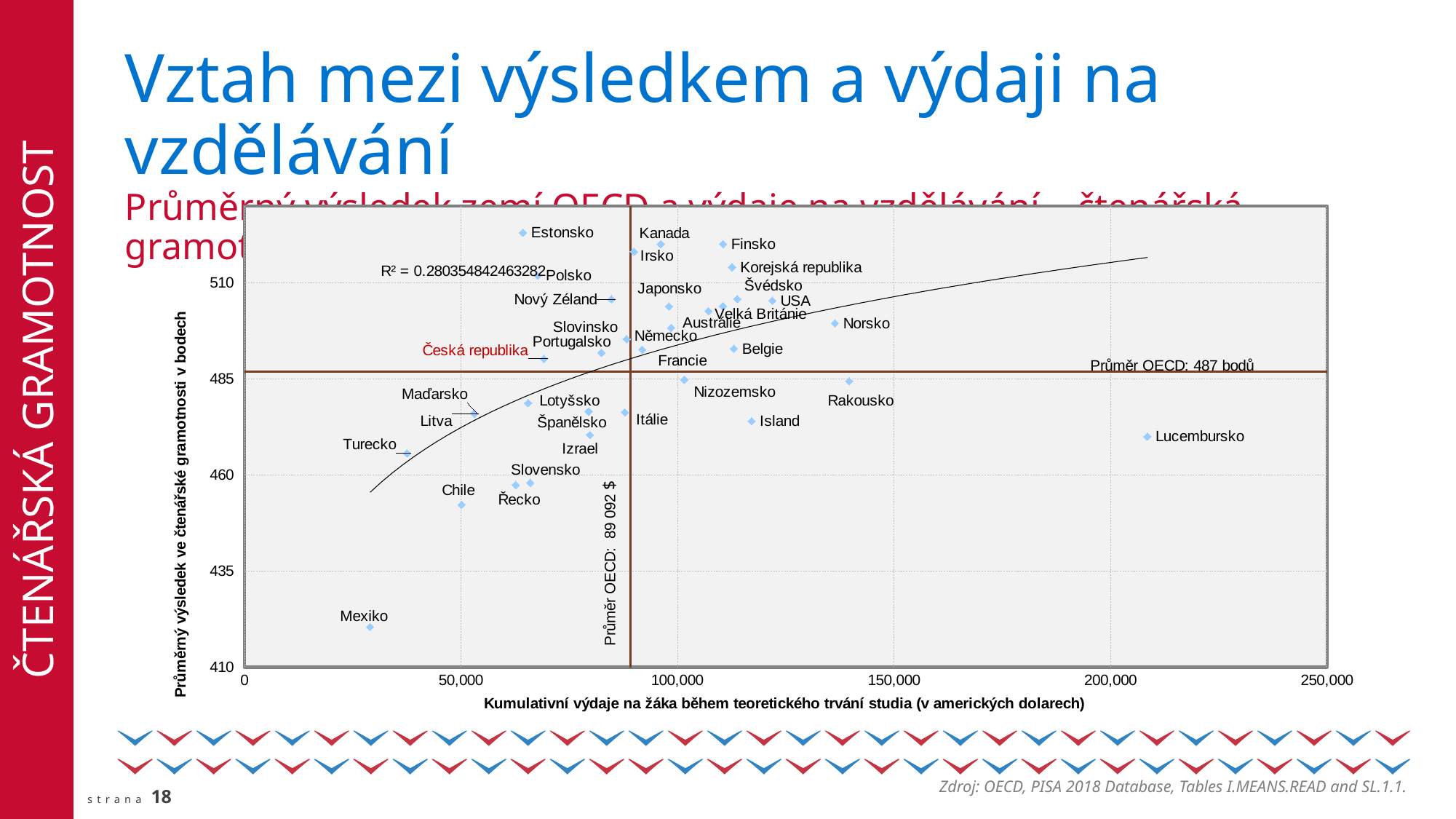
According to the fitted trend line, does the average reading score rise or fall as cumulative spending per student increases? rises Which country has the lowest average reading score in the chart? Mexiko Which country has the higher average reading score, Chile or Mexiko? Chile Which country has the highest average reading score in the chart? Estonsko Is the cumulative spending per student for Turecko greater or less than 50,000? less Is the cumulative spending per student for Lucembursko greater or less than 200,000? greater What R² value is printed on the chart? 0.280354842463282 Is the average reading score for Mexiko greater or less than 435? less What is the OECD average reading score marked by the horizontal line? 487 bodů Which country has the highest cumulative spending per student in the chart? Lucembursko What kind of chart is shown on the slide? scatter chart What is the OECD average cumulative spending per student marked by the vertical line? 89 092 $